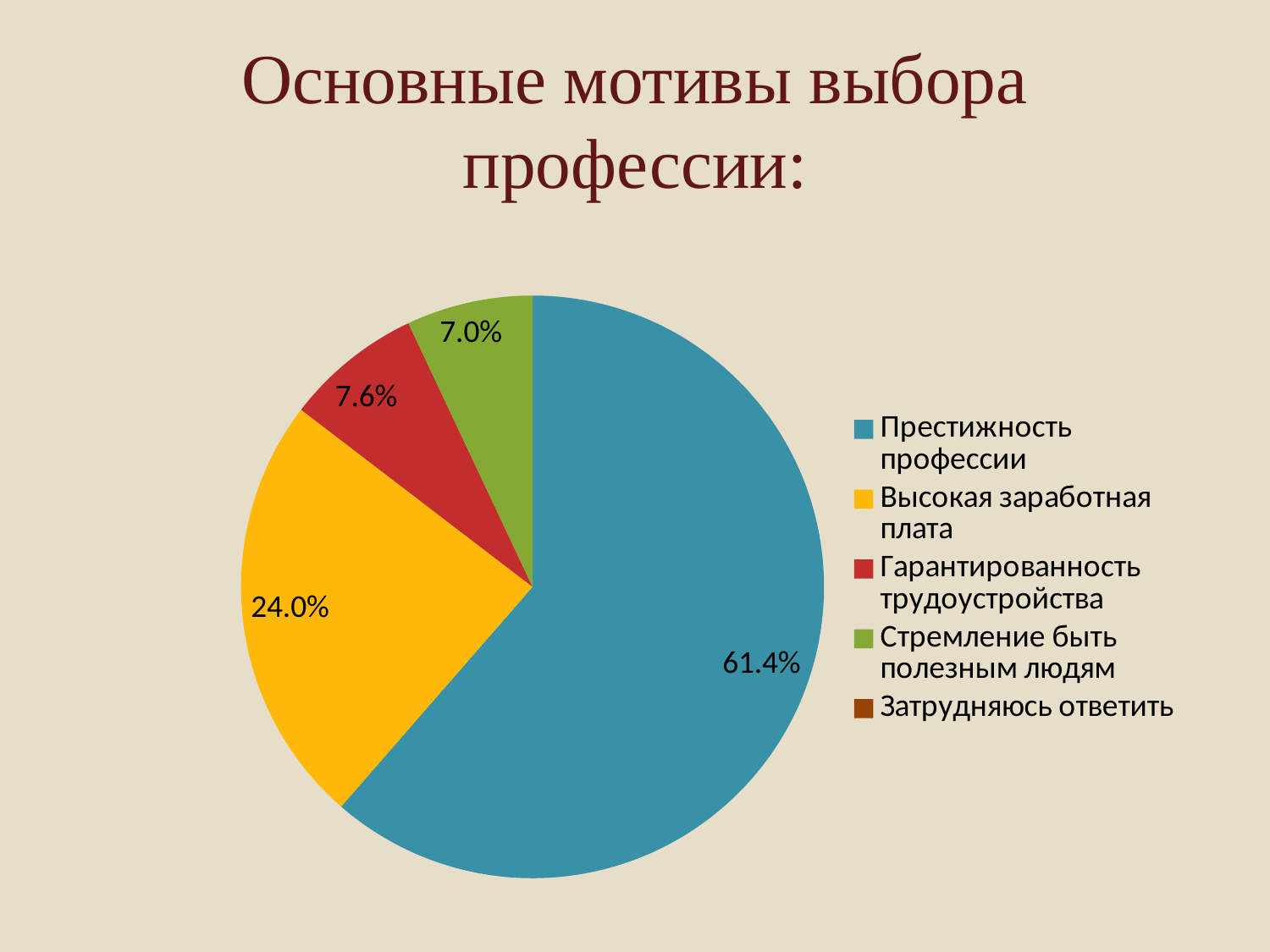
Which motive has the largest share of the pie? Престижность профессии What percentage is shown for "Гарантированность трудоустройства"? 7.6% By how many percentage points does "Престижность профессии" exceed "Высокая заработная плата"? 37.4 What kind of chart is shown on the slide? pie chart What colour is the slice for "Высокая заработная плата"? yellow What percentage is shown for "Стремление быть полезным людям"? 7.0% What percentage is shown for "Престижность профессии"? 61.4% How many entries does the legend list? 5 Which is larger: the share for "Гарантированность трудоустройства" or for "Стремление быть полезным людям"? Гарантированность трудоустройства What is the title of the slide? Основные мотивы выбора профессии: What percentage is shown for "Высокая заработная плата"? 24.0% Of the slices with a printed data label, which has the smallest share? Стремление быть полезным людям